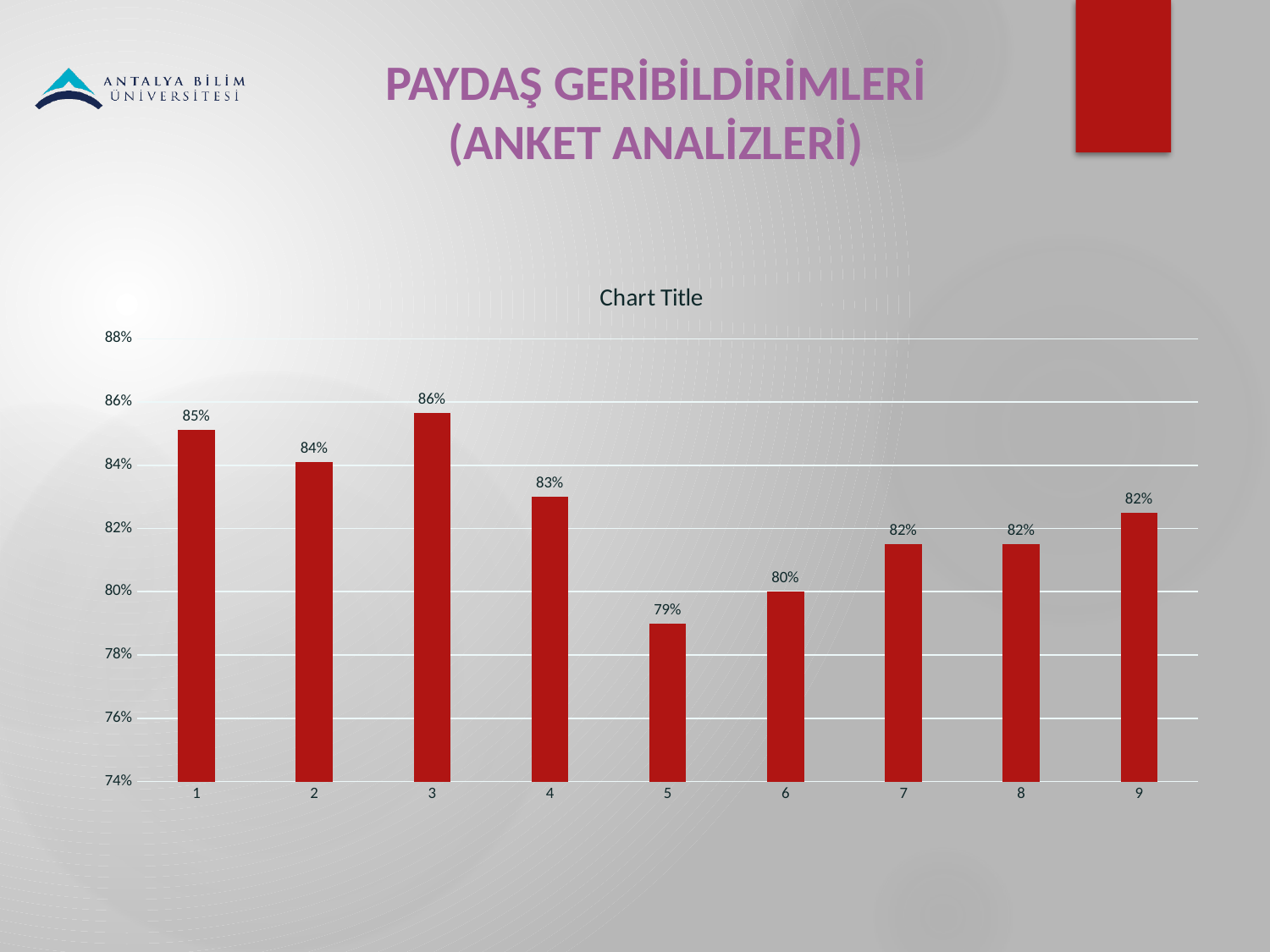
Is the value for category 5 greater or less than 80%? less Which category has the lowest value? 5 How many categories are shown on the x axis? 9 What kind of chart is shown on the slide? bar chart What is the difference between the values for category 1 and category 2? 1% What is the value for category 3? 86% What is the difference between the values for category 3 and category 5? 7% What is the value for category 6? 80% What is the value for category 5? 79% Which is larger, the value for category 4 or the value for category 6? category 4 What is the value for category 1? 85% Which category has the highest value? 3